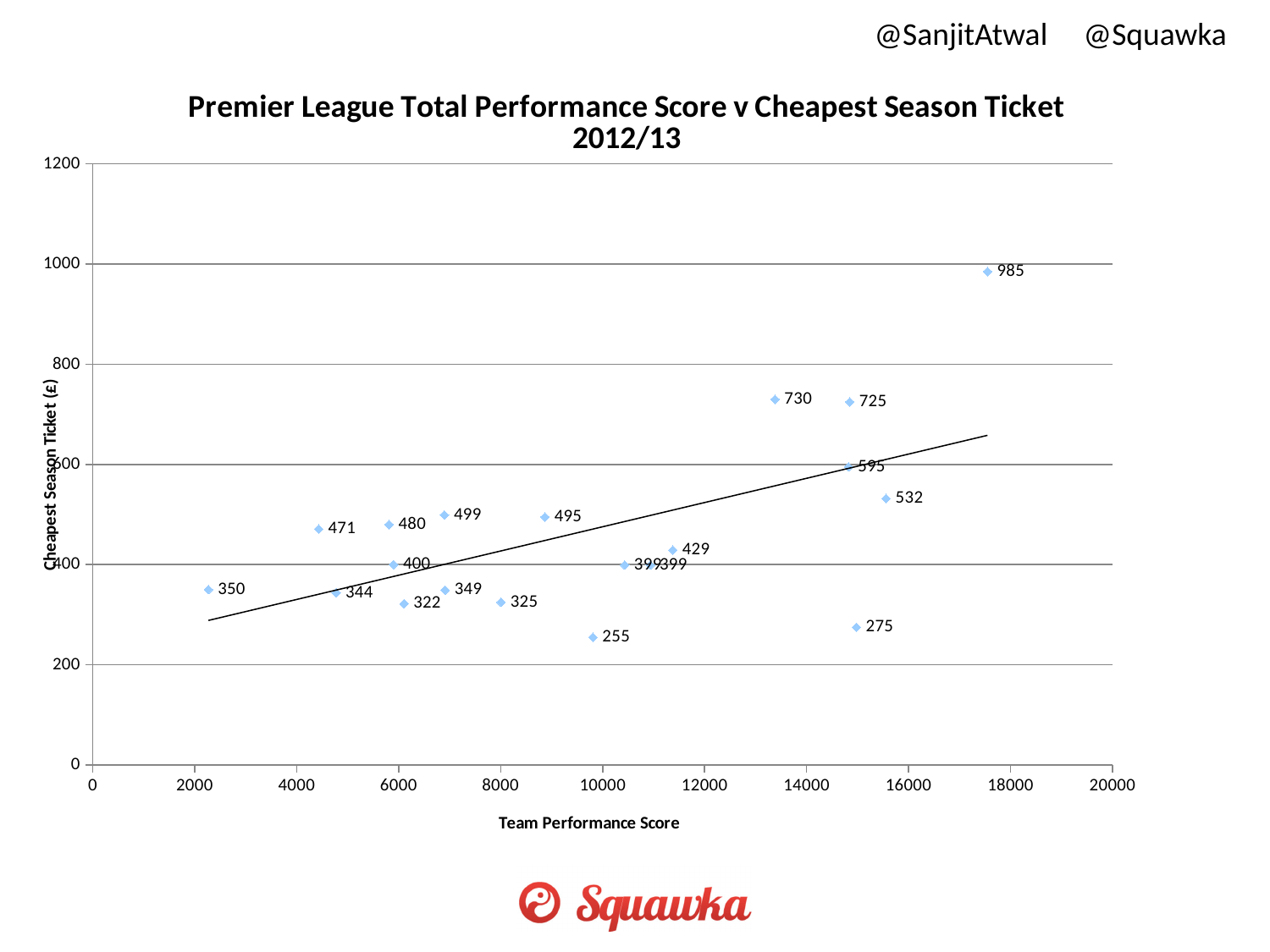
What is the lowest cheapest season ticket value plotted on the chart? 255 What is the difference between the highest and lowest cheapest season ticket values plotted? 730 Is the cheapest season ticket value for the point with the highest team performance score greater or less than 800? greater What is the title of the chart? Premier League Total Performance Score v Cheapest Season Ticket 2012/13 What is the label of the y axis? Cheapest Season Ticket (£) What kind of chart is shown on the slide? scatter chart How many plotted points have a cheapest season ticket value above 600? 3 What is the difference between the data points labelled 730 and 725? 5 How many data points are plotted on the chart? 20 Does the trend line show cheapest season ticket price rising or falling as team performance score increases? rising Which is larger, the data point labelled 730 or the data point labelled 725? 730 What is the highest cheapest season ticket value plotted on the chart? 985